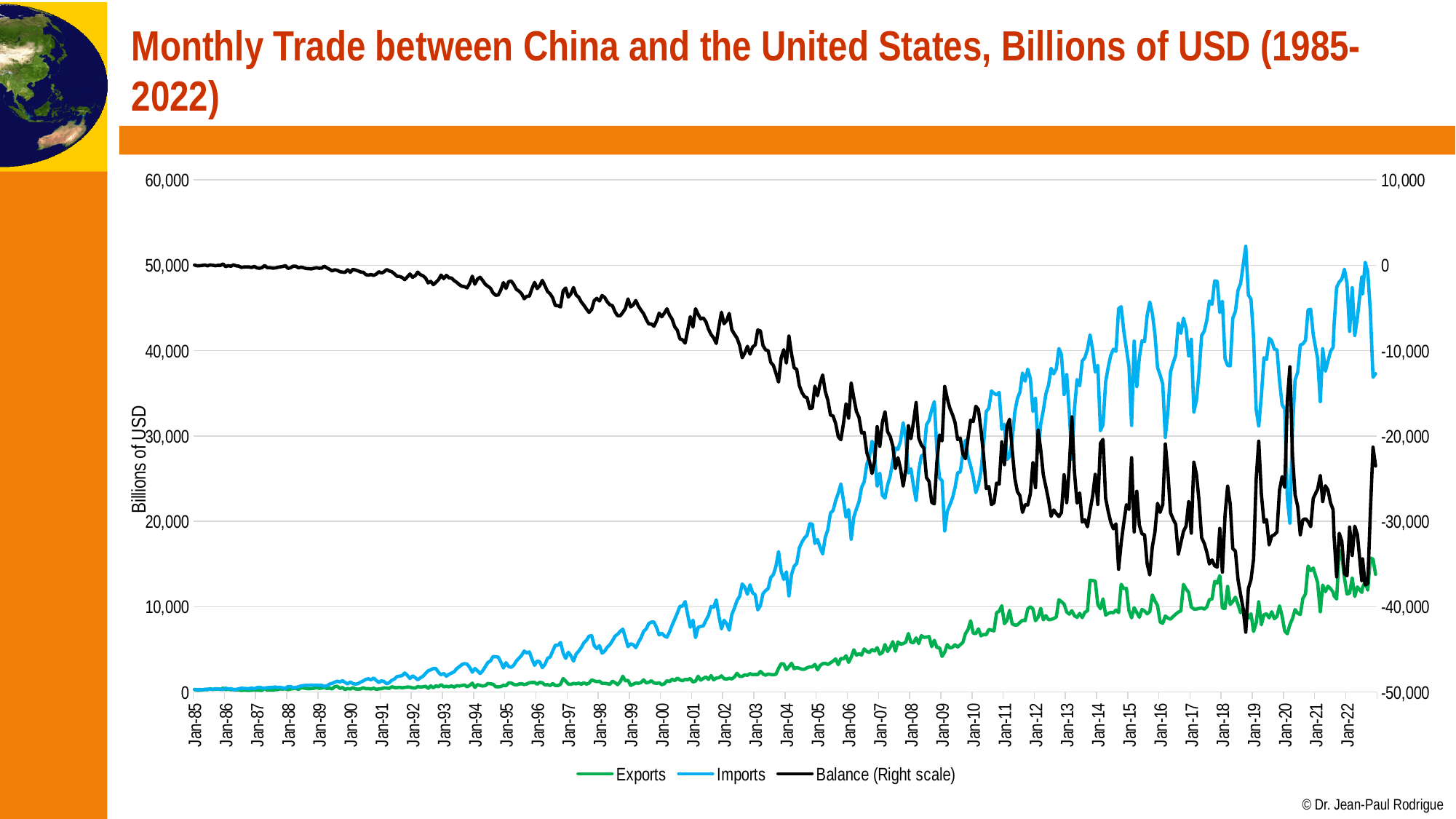
How many series does the legend list? 3 Do the Imports values generally rise or fall from Jan-85 to Jan-22? rise Is the Imports value around Jan-00 greater or less than 10,000? less Does the Balance series generally rise or fall from Jan-85 to Jan-22? fall What is the label of the left vertical axis? Billions of USD Around Jan-15, which is larger, Imports or Exports? Imports Is the Exports value around Jan-10 greater or less than 10,000? less Is the Balance value around Jan-15 greater or less than -20,000 on the right scale? less What kind of chart is shown on the slide? line chart Which series is plotted on the right scale according to the legend? Balance (Right scale) Which series reaches the highest value on the left scale over the whole period? Imports